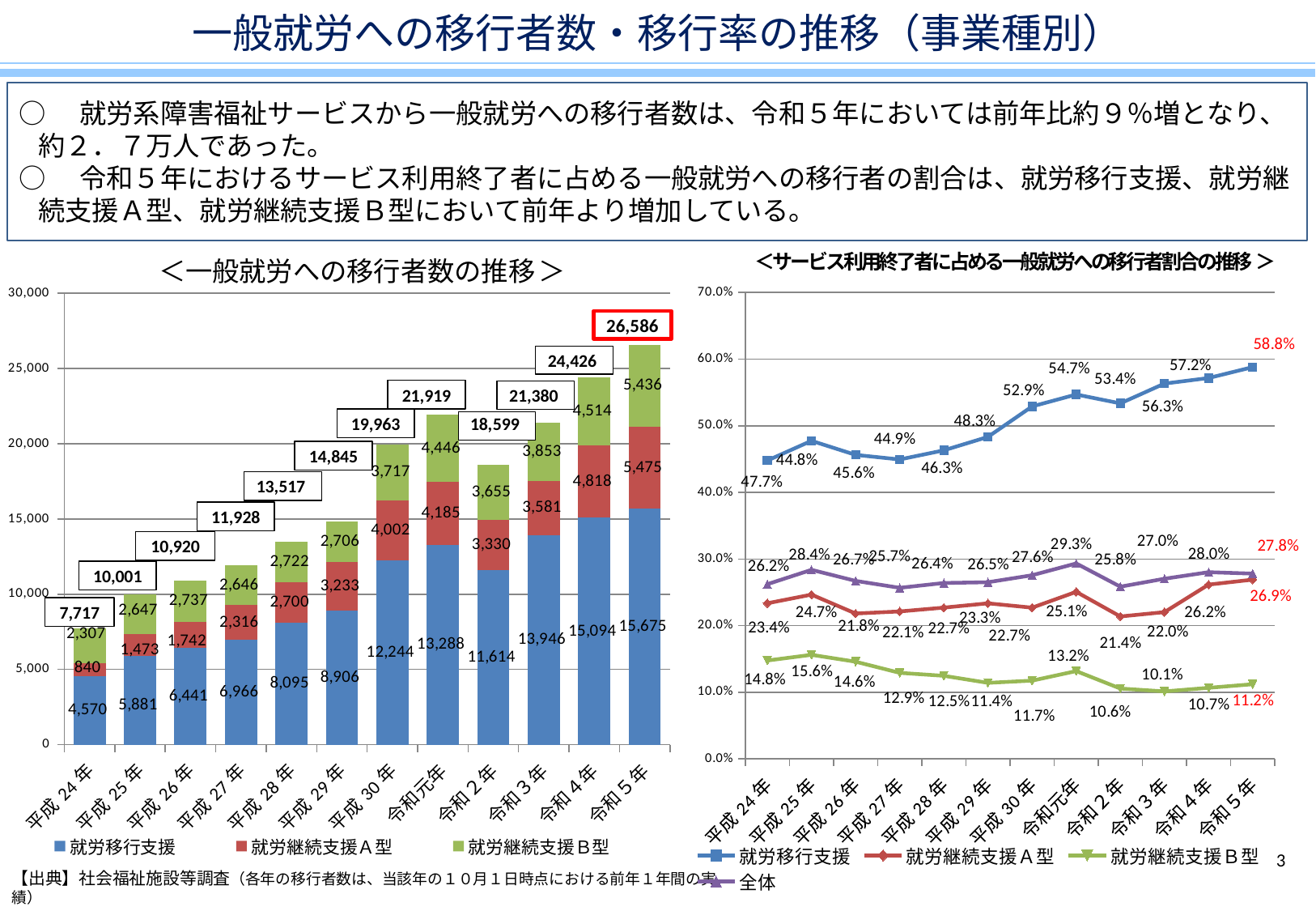
In the left chart (一般就労への移行者数の推移), what is the value of 就労移行支援 for 平成24年? 4,570 In the left chart (一般就労への移行者数の推移), what is the difference between the totals for 令和5年 and 令和4年? 2,160 In the right chart (サービス利用終了者に占める一般就労への移行者割合の推移), what is the value of 就労移行支援 for 令和5年? 58.8% In the left chart (一般就労への移行者数の推移), how many series does the legend list? 3 In the right chart (サービス利用終了者に占める一般就労への移行者割合の推移), what is the value of 就労継続支援Ｂ型 for 令和5年? 11.2% In the right chart (サービス利用終了者に占める一般就労への移行者割合の推移), how many series does the legend list? 4 In the left chart (一般就労への移行者数の推移), how many years are shown on the x axis? 12 What kind of chart is the left chart (一般就労への移行者数の推移)? Stacked bar chart In the left chart (一般就労への移行者数の推移), what is the value of 就労継続支援Ａ型 for 令和4年? 4,818 In the right chart (サービス利用終了者に占める一般就労への移行者割合の推移), which series has the highest value in 令和5年? 就労移行支援 In the left chart (一般就労への移行者数の推移), what is the total for 令和5年? 26,586 In the left chart (一般就労への移行者数の推移), which year has the lowest total? 平成24年